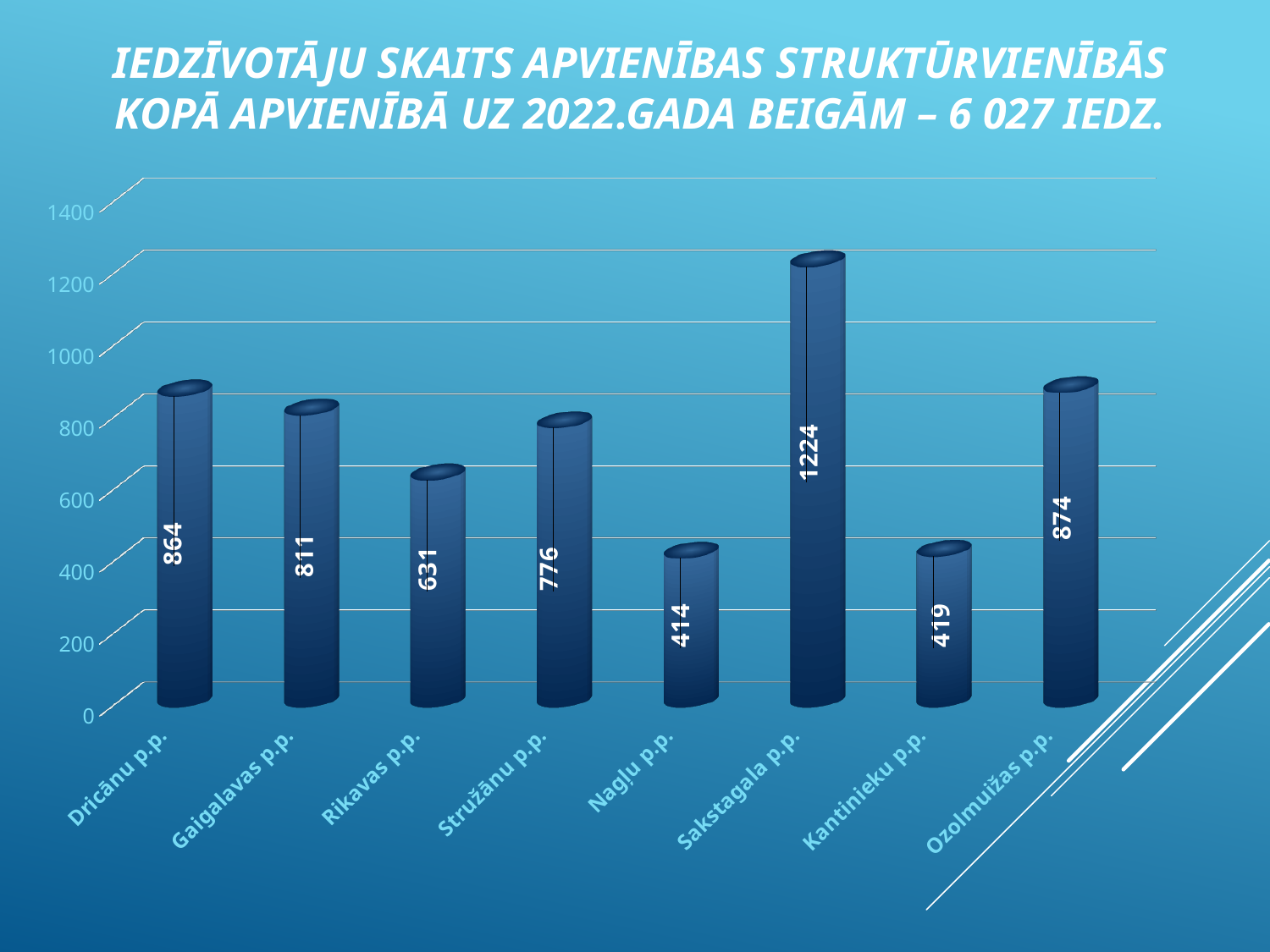
Which category has the highest value? Sakstagala p.p. What is the difference between the values for Sakstagala p.p. and Ozolmuižas p.p.? 350 What is the value for Nagļu p.p.? 414 What is the value for Dricānu p.p.? 864 What total number of residents does the chart title state for the whole association at the end of 2022? 6 027 What is the value for Sakstagala p.p.? 1224 Which is larger, the value for Gaigalavas p.p. or the value for Stružānu p.p.? Gaigalavas p.p. What kind of chart is shown on the slide? bar chart How many categories are shown on the x axis? 8 Which category has the lowest value? Nagļu p.p. Is the value for Rikavas p.p. greater or less than 800? less What is the difference between the values for Kantinieku p.p. and Nagļu p.p.? 5